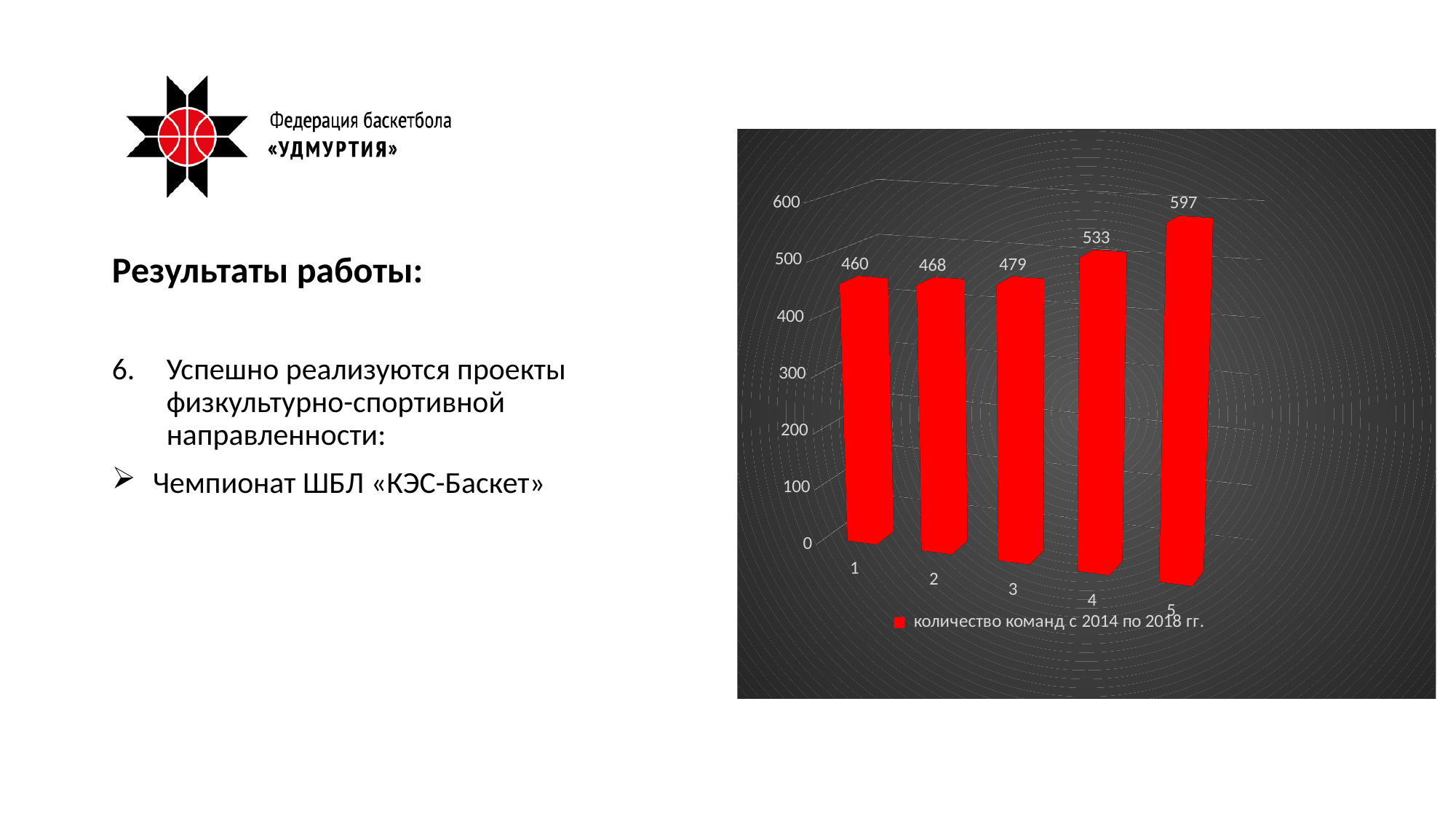
How many categories are shown in the chart? 5 Which category has the highest value in the chart? 5 What is the value for category 3 in the chart? 479 What is the value for category 4 in the chart? 533 What is the difference between the values for category 5 and category 1? 137 What is the difference between the values for category 4 and category 3? 54 How many series does the legend list? 1 What is the value for category 1 in the chart? 460 What kind of chart is shown on the slide? bar chart Do the values rise or fall from category 1 to category 5? rise Which is larger, the value for category 2 or the value for category 4? 4 Which category has the lowest value in the chart? 1